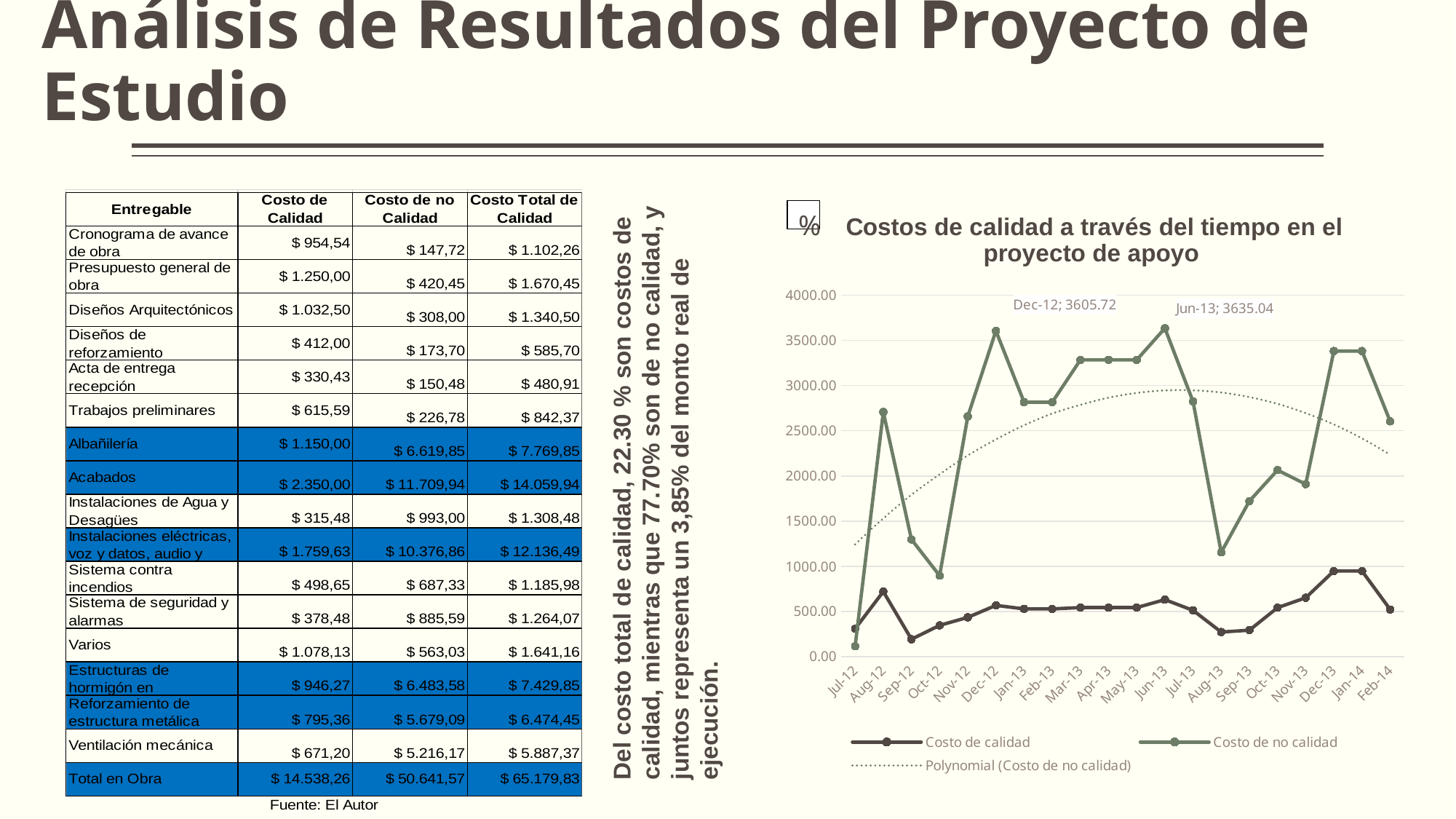
What is the value of Costo de no calidad in Dec-12? 3605.72 What kind of chart is shown on the slide? line chart Is the value of Costo de no calidad in Aug-13 greater or less than 1500? less Which series has the larger value in Dec-12, Costo de calidad or Costo de no calidad? Costo de no calidad Is the value of Costo de calidad in Aug-12 greater or less than 500? greater What is the title of the chart? Costos de calidad a través del tiempo en el proyecto de apoyo What is the difference between the Costo de no calidad values in Jun-13 and Dec-12? 29.32 In which month does Costo de no calidad reach its highest value? Jun-13 How many entries does the legend list? 3 In which month is Costo de no calidad at its lowest? Jul-12 What is the value of Costo de no calidad in Jun-13? 3635.04 How many months are plotted along the x axis? 20